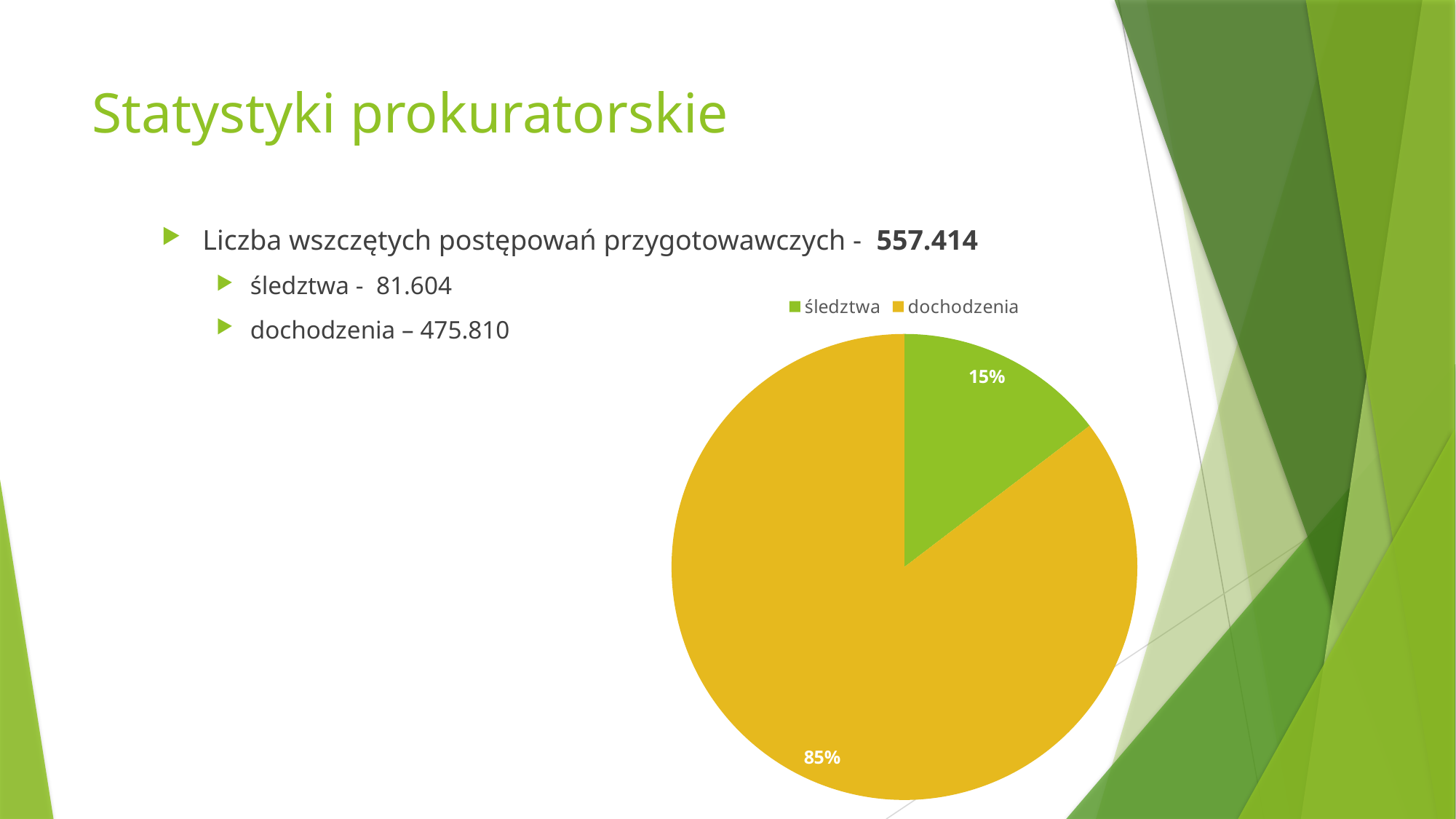
What is the difference in percentage points between the dochodzenia slice and the śledztwa slice? 70 What share of the pie does dochodzenia represent? 85% Which is larger in the pie chart, śledztwa or dochodzenia? dochodzenia How many slices does the pie chart have? 2 What colour is the śledztwa slice in the pie chart? green Which slice of the pie is the smallest? śledztwa How many entries does the legend list? 2 What colour is the dochodzenia slice in the pie chart? yellow What kind of chart is shown on the slide? pie chart Which slice of the pie is the largest? dochodzenia What share of the pie does śledztwa represent? 15%